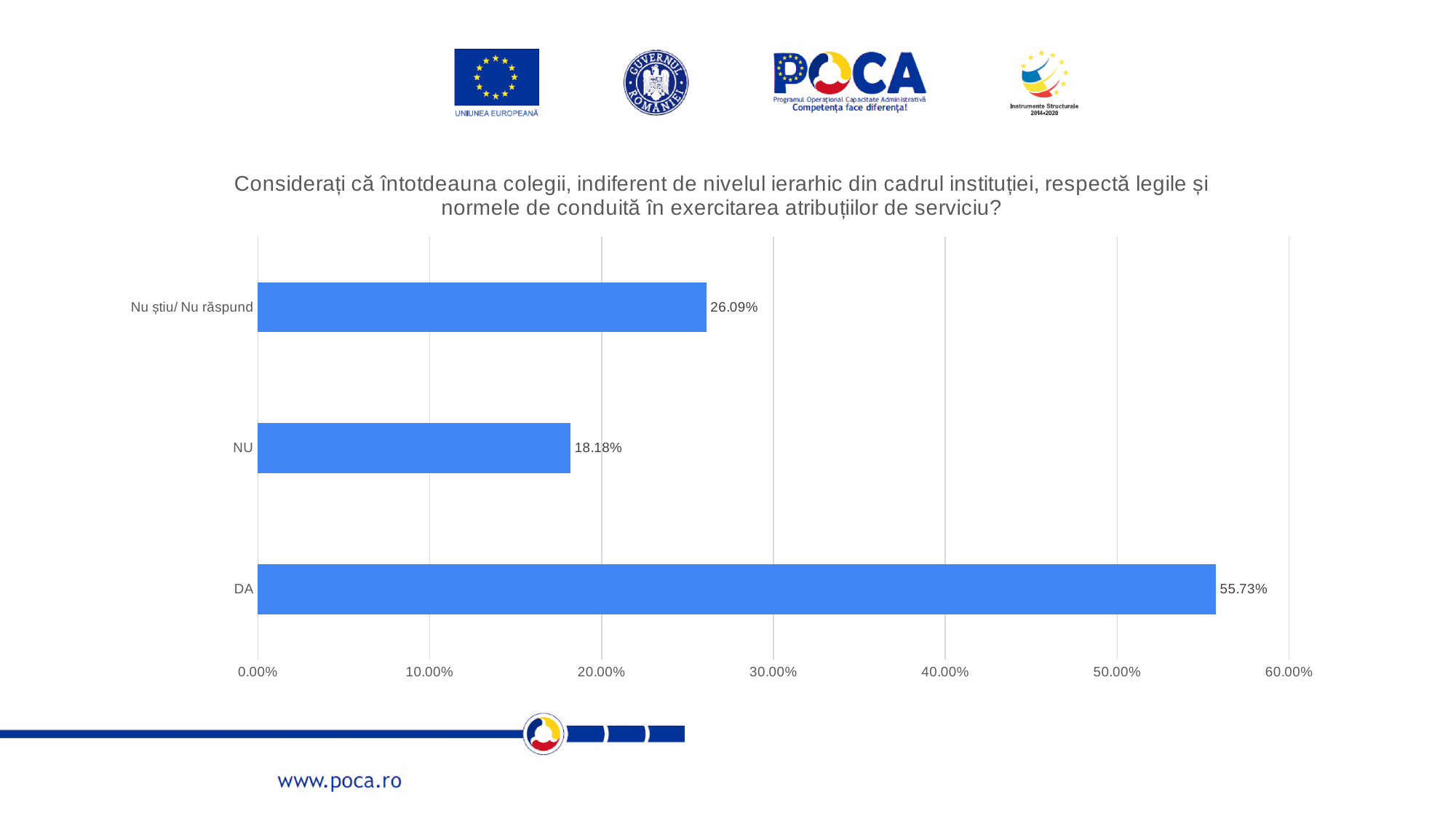
What is the value for DA? 55.73% What is the difference between the values for Nu știu/ Nu răspund and NU? 7.91% How many categories are shown in the chart? 3 Which category has the lowest value? NU Which category has the highest value? DA Which is larger, the value for NU or the value for Nu știu/ Nu răspund? Nu știu/ Nu răspund What kind of chart is shown on the slide? bar chart What is the difference between the values for DA and NU? 37.55% What is the highest value shown on the x axis? 60.00% What is the value for Nu știu/ Nu răspund? 26.09% What is the value for NU? 18.18% Is the value for DA greater or less than 50.00%? greater